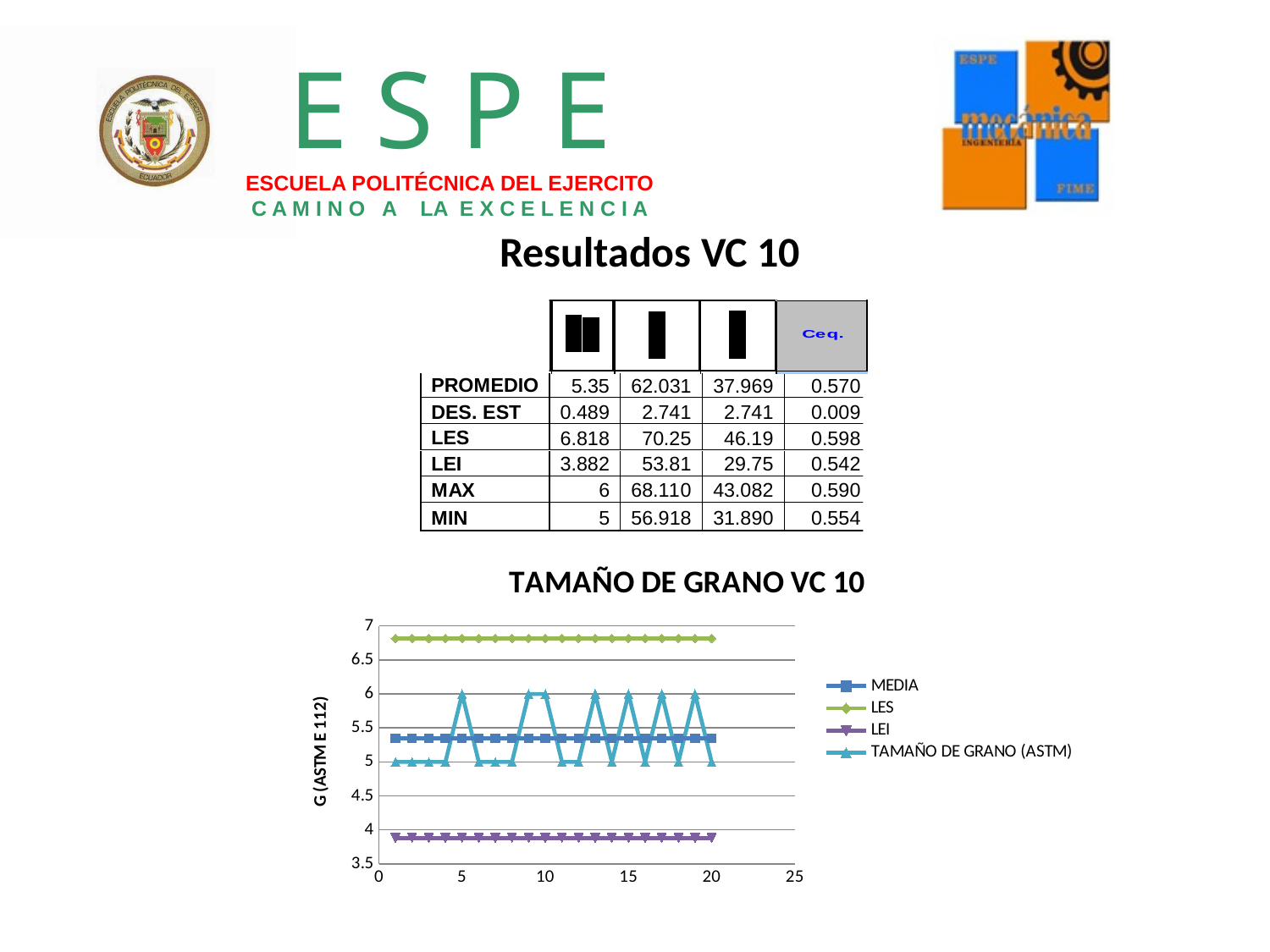
In the TAMAÑO DE GRANO VC 10 chart, is the LEI line greater or less than 4? less In the TAMAÑO DE GRANO VC 10 chart, is the MEDIA line greater or less than 5? greater In the TAMAÑO DE GRANO VC 10 chart, is the LES line greater or less than 6.5? greater In the TAMAÑO DE GRANO VC 10 chart, what is the lowest value reached by the TAMAÑO DE GRANO (ASTM) series? 5 In the TAMAÑO DE GRANO VC 10 chart, which series is plotted higher, MEDIA or LEI? MEDIA In the TAMAÑO DE GRANO VC 10 chart, does the LES series rise, fall, or stay flat along the x axis? stays flat What kind of chart is shown under the title TAMAÑO DE GRANO VC 10? line chart What is the label of the vertical axis in the TAMAÑO DE GRANO VC 10 chart? G (ASTM E 112) How many series does the legend of the TAMAÑO DE GRANO VC 10 chart list? 4 What is the title of the chart at the bottom of the slide? TAMAÑO DE GRANO VC 10 In the TAMAÑO DE GRANO VC 10 chart, which series is plotted higher, LES or LEI? LES In the TAMAÑO DE GRANO VC 10 chart, what is the highest value reached by the TAMAÑO DE GRANO (ASTM) series? 6